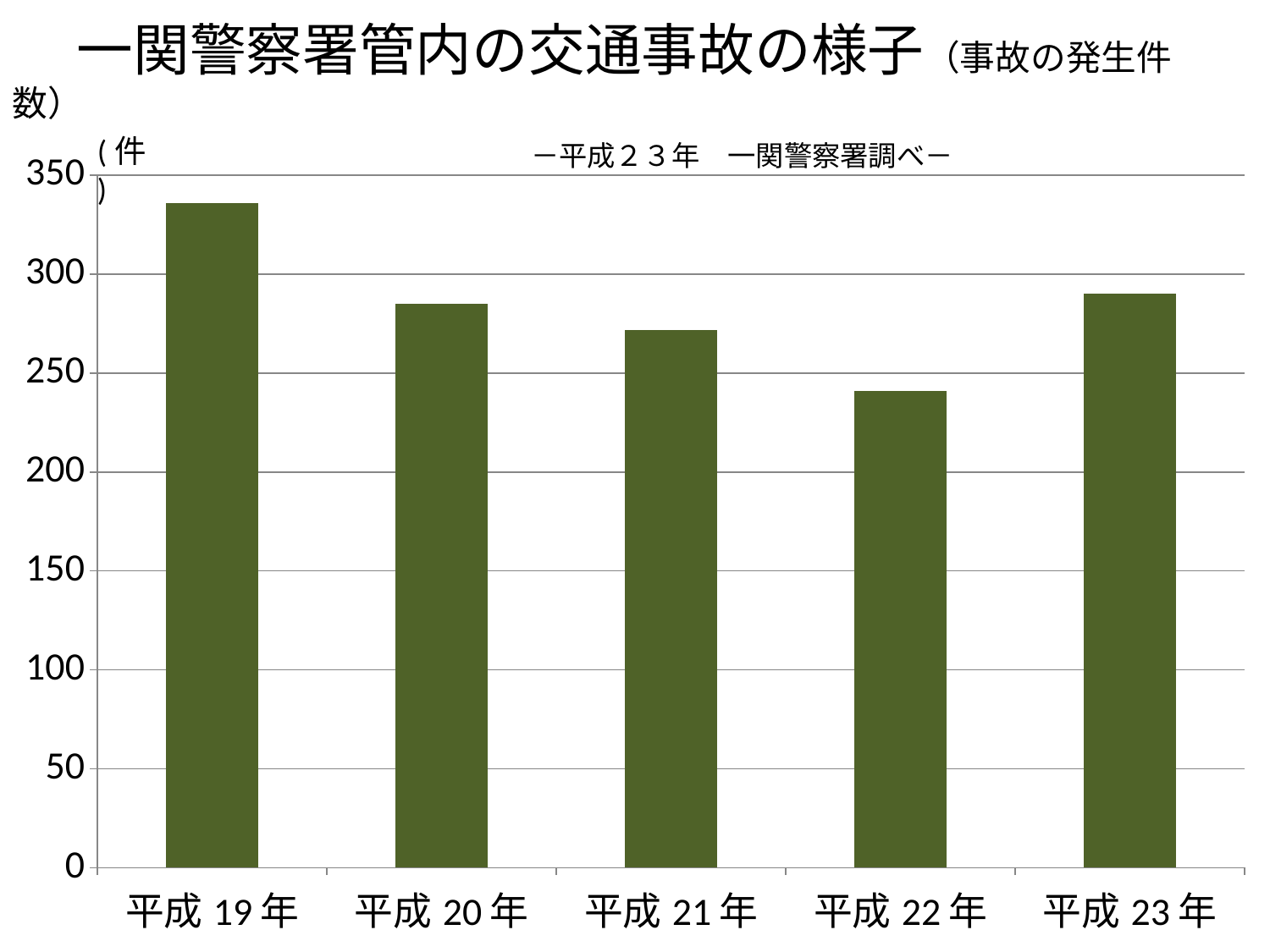
Which year has the lowest number of accidents? 平成22年 Is the value for 平成23年 greater or less than 300? less From 平成19年 to 平成22年, do the values rise or fall? fall Is the value for 平成21年 greater or less than 250? greater What unit is shown on the vertical axis of the chart? 件 Which is larger, the value for 平成21年 or the value for 平成22年? 平成21年 Is the value for 平成22年 greater or less than 250? less What kind of chart is shown on the slide? bar chart How many years (categories) are plotted on the chart? 5 Which is larger, the value for 平成19年 or the value for 平成23年? 平成19年 Which year has the highest number of accidents? 平成19年